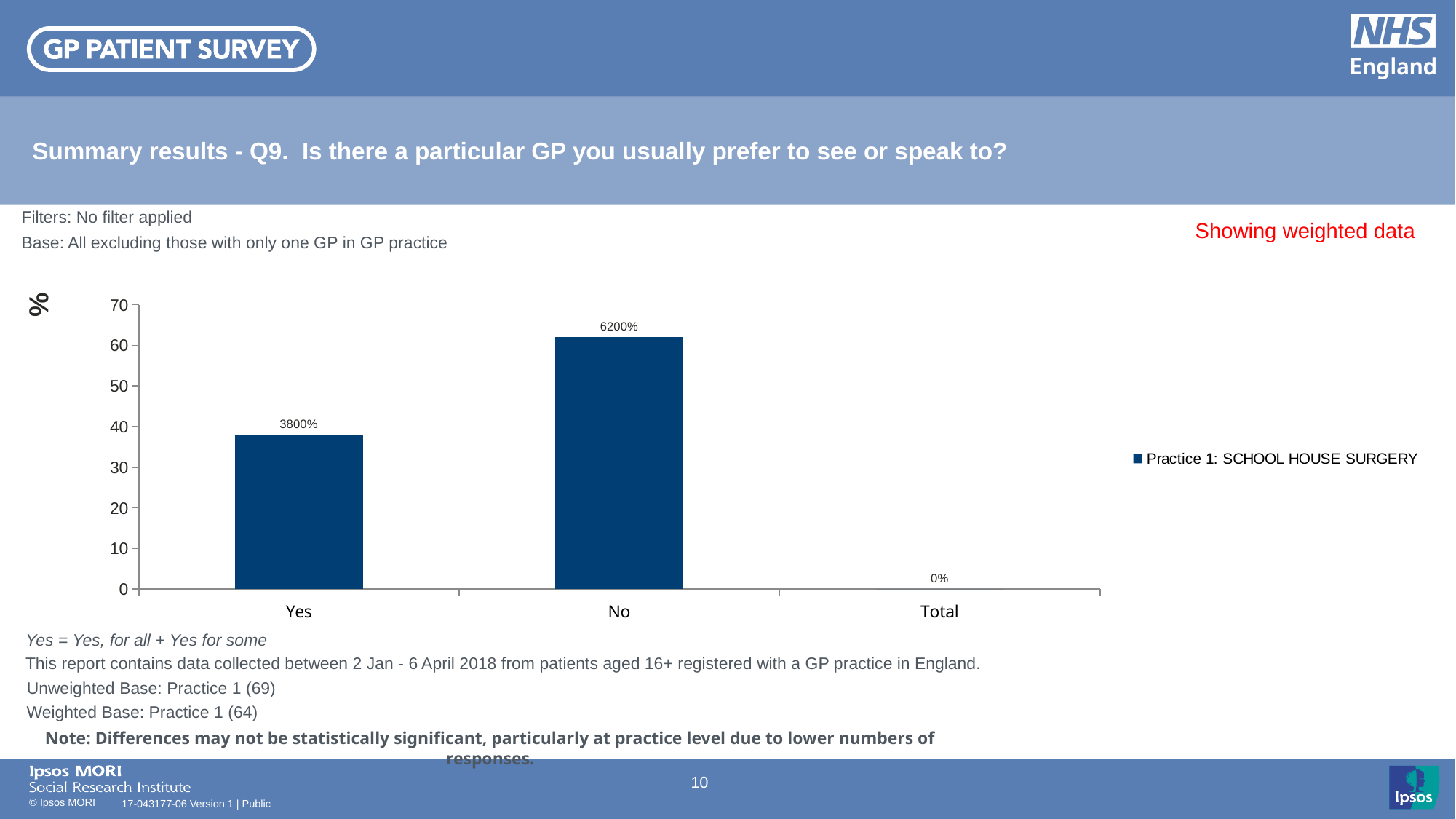
Is the bar for No greater or less than 60 on the axis? greater How many series does the legend list? 1 What is the data label shown on the bar for No? 6200% How many categories are shown on the x axis? 3 Which is larger, the bar for Yes or the bar for No? No What is the data label shown for Total? 0% What is the data label shown on the bar for Yes? 3800% What is the name of the series in the legend? Practice 1: SCHOOL HOUSE SURGERY Which category has the lowest value? Total Which category has the highest bar? No Is the bar for Yes greater or less than 40 on the axis? less What kind of chart is shown on the slide? bar chart